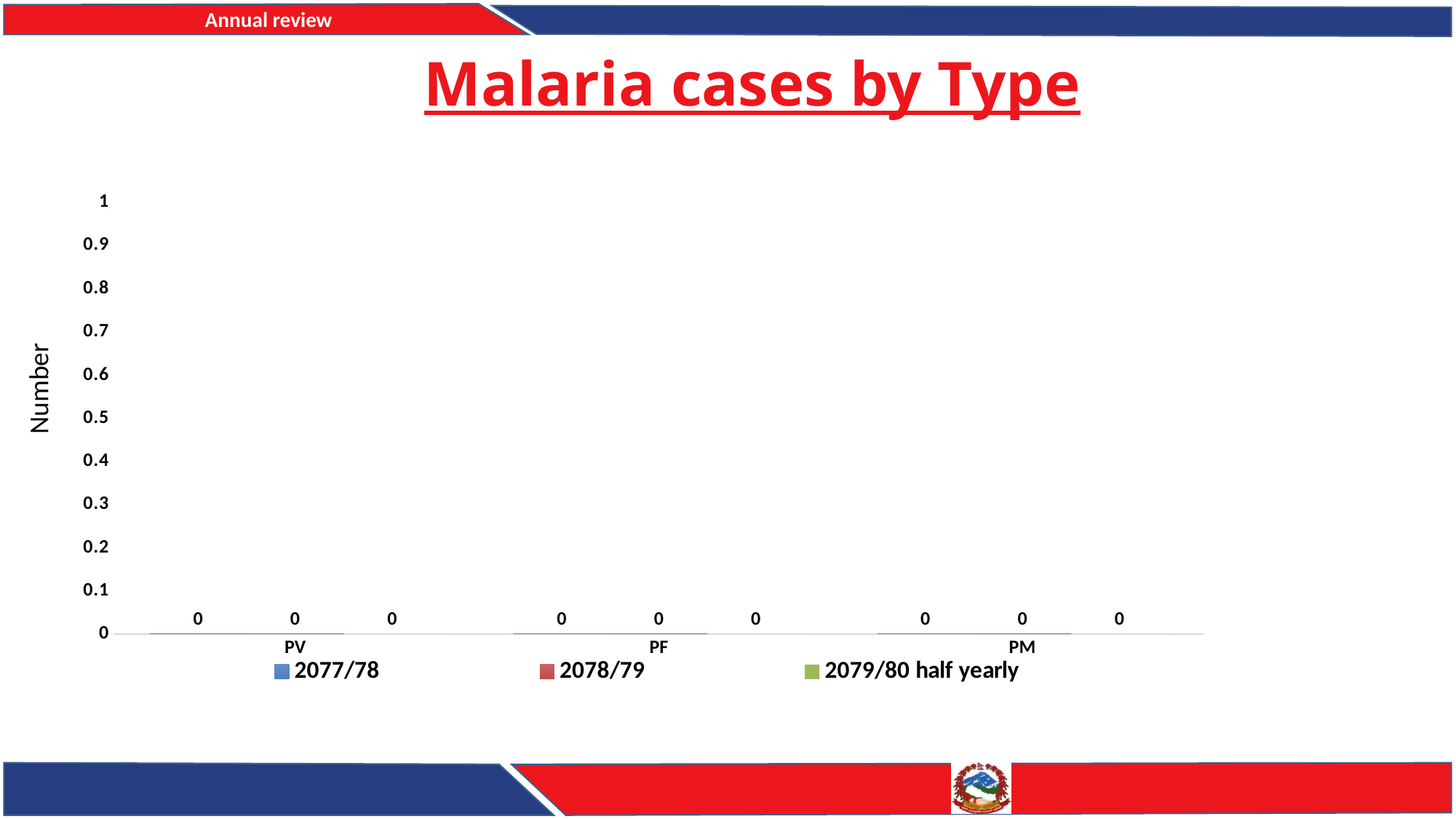
What is the label on the vertical axis? Number What is the value for PM in the 2079/80 half yearly series? 0 How many series does the legend list? 3 Is the value for PV in the 2079/80 half yearly series greater or less than 0.5? less What is the value for PM in the 2077/78 series? 0 What is the difference between the PV and PF values in the 2078/79 series? 0 How many malaria type categories are shown on the x axis? 3 What is the title of the chart? Malaria cases by Type What is the value for PF in the 2078/79 series? 0 What kind of chart is shown on the slide? Bar chart What is the value for PV in the 2077/78 series? 0